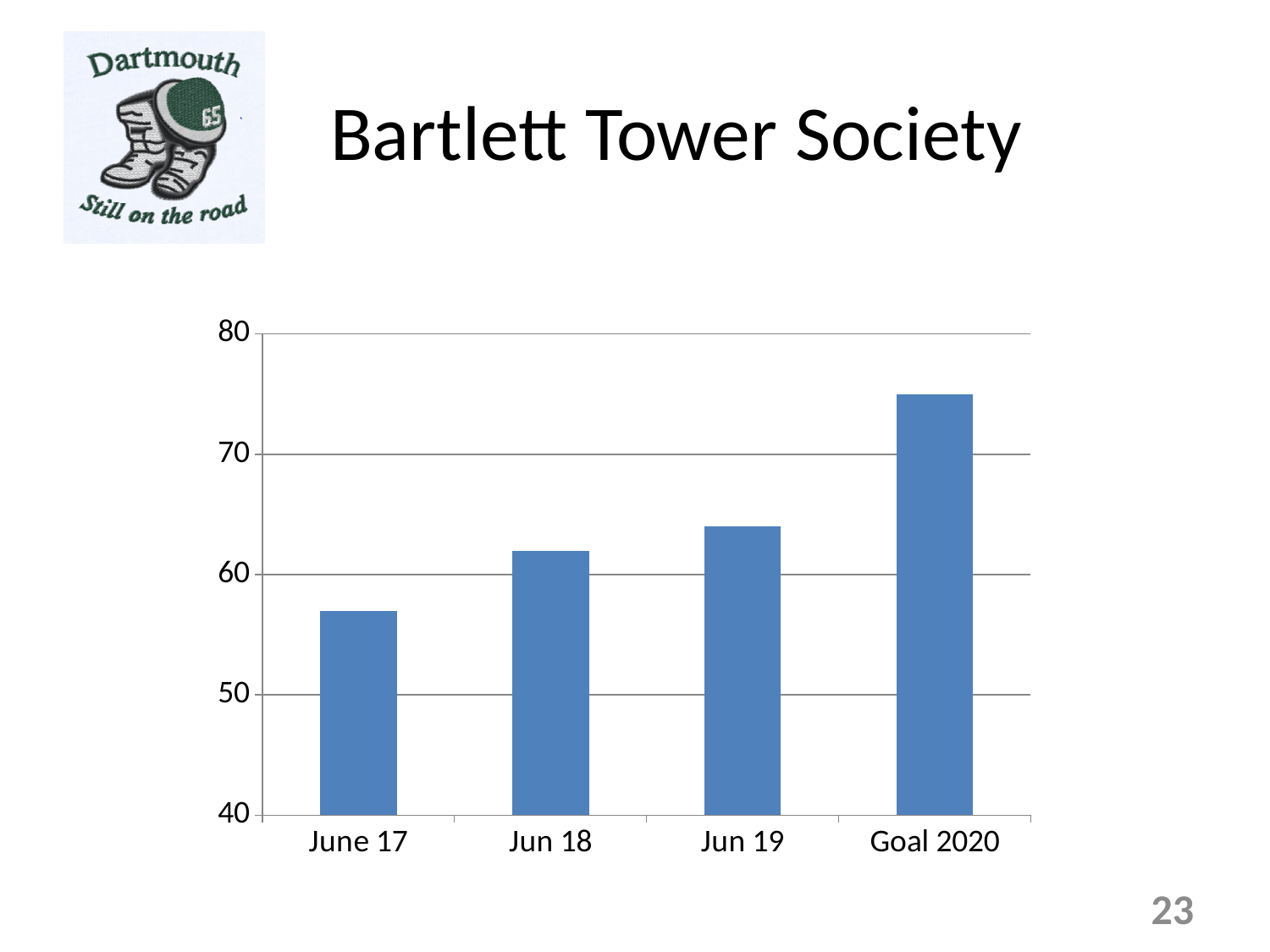
What is the title shown above the chart on the slide? Bartlett Tower Society What kind of chart is shown on the slide? bar chart Do the values rise or fall from June 17 to Goal 2020 along the x axis? rise Which is larger, the value for Jun 19 or the value for June 17? Jun 19 Is the value for Jun 19 greater or less than 60? greater Is the value for June 17 greater or less than 50? greater Is the value for Goal 2020 greater or less than 80? less Which category has the lowest bar? June 17 How many bars are plotted in the chart? 4 Which category has the highest bar? Goal 2020